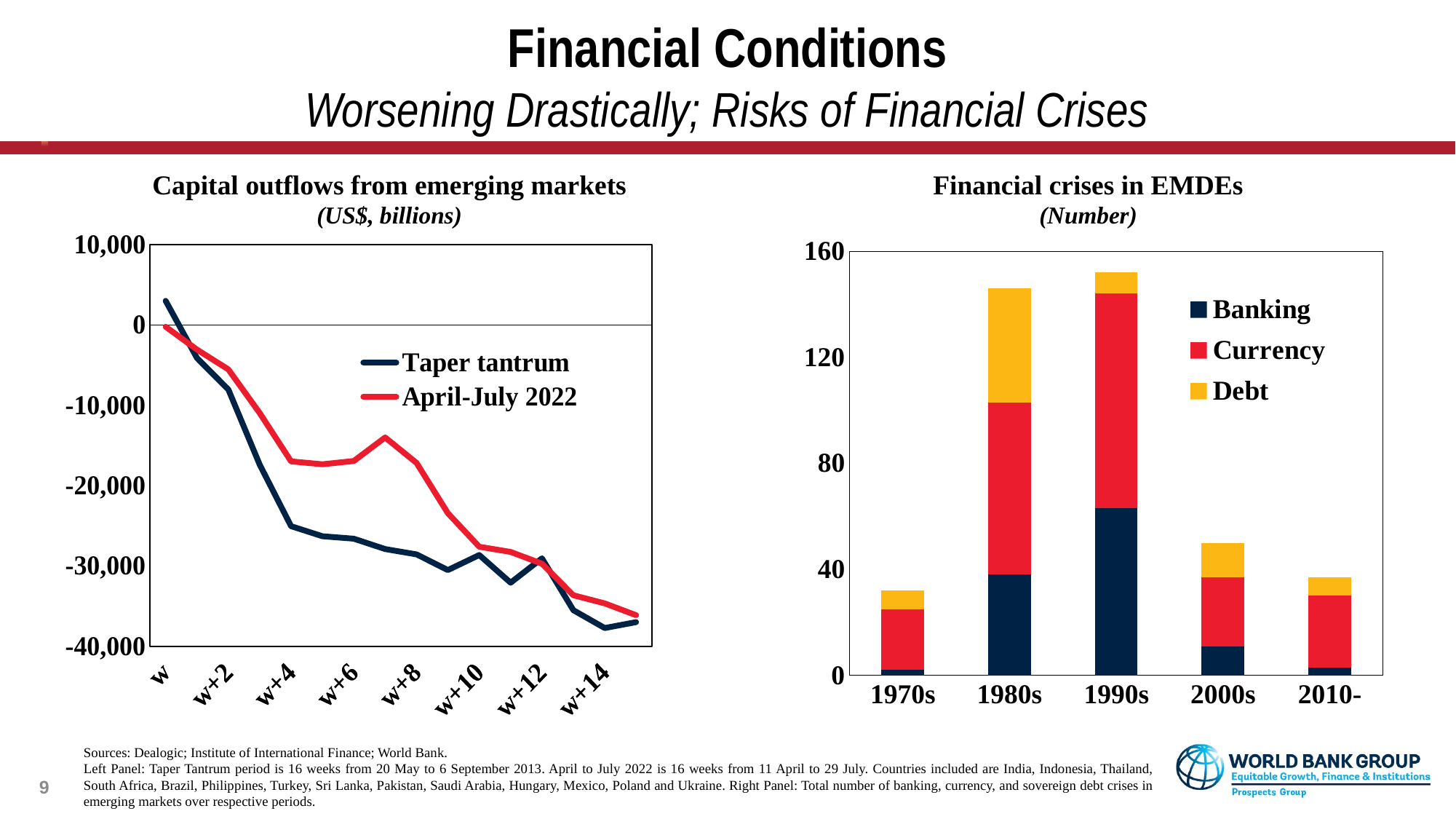
In the right chart, 'Financial crises in EMDEs', is the total for the 1970s greater or less than 40? less In the left chart, 'Capital outflows from emerging markets', is the Taper tantrum value at w+4 greater or less than -20,000? less In the left chart, 'Capital outflows from emerging markets', at w+4 which series has the higher (less negative) value, Taper tantrum or April-July 2022? April-July 2022 What type of chart is the left chart, 'Capital outflows from emerging markets'? line chart In the right chart, 'Financial crises in EMDEs', how many series does the legend list? 3 In the right chart, 'Financial crises in EMDEs', which decade has the largest Banking segment? 1990s In the left chart, 'Capital outflows from emerging markets', how many series does the legend list? 2 In the right chart, 'Financial crises in EMDEs', is the total for the 1980s greater or less than 120? greater In the left chart, 'Capital outflows from emerging markets', do the values for the Taper tantrum series generally rise or fall from w to w+14? fall What type of chart is the right chart, 'Financial crises in EMDEs'? stacked bar chart In the right chart, 'Financial crises in EMDEs', which decade has the largest Debt segment? 1980s In the right chart, 'Financial crises in EMDEs', how many decade categories are shown on the x axis? 5